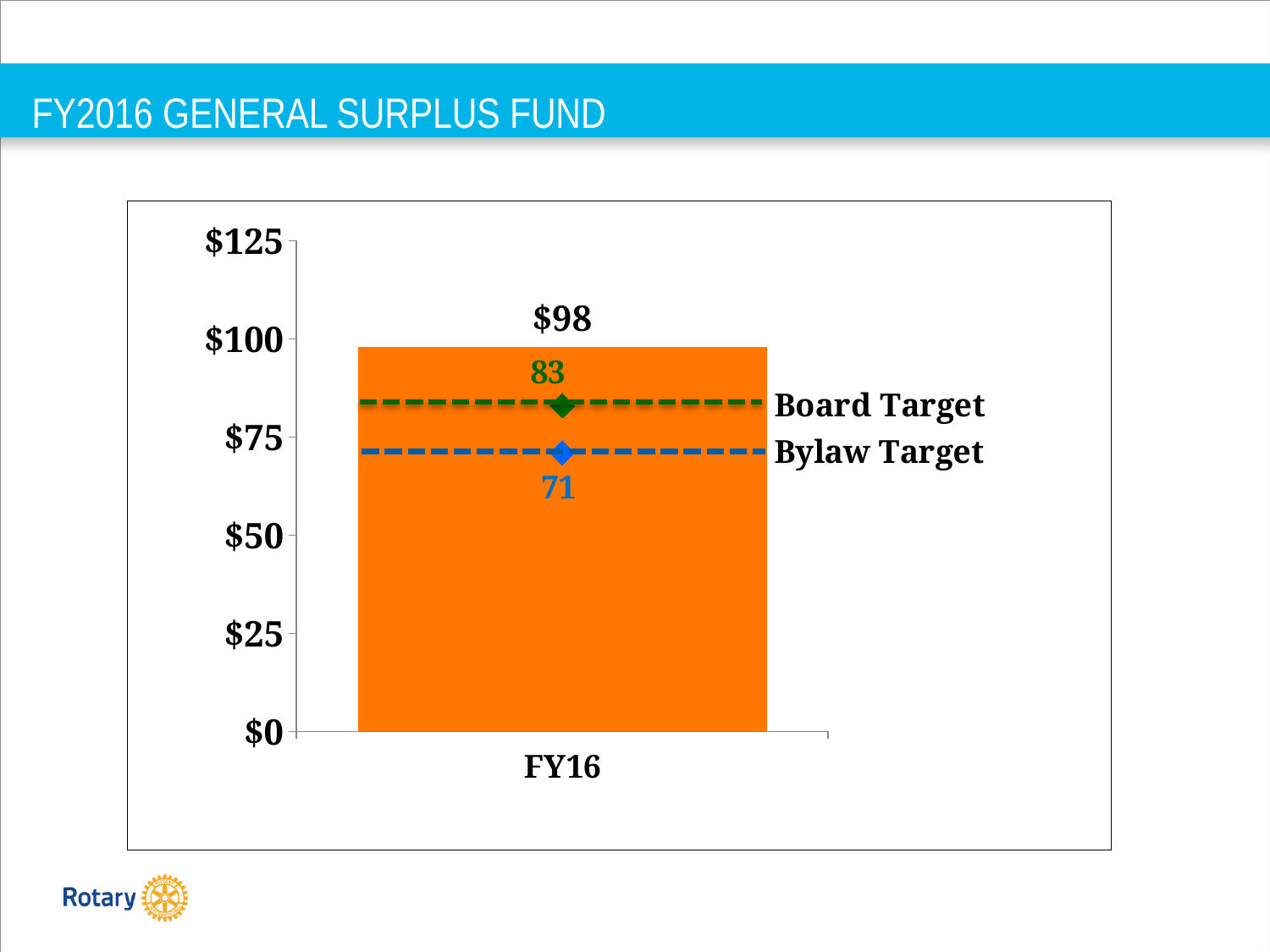
Which is higher, the Board Target or the Bylaw Target? Board Target What kind of chart is shown on the slide? bar chart What is the title of the slide? FY2016 GENERAL SURPLUS FUND What is the difference between the Board Target and the Bylaw Target? 12 What is the difference between the FY16 bar value and the Board Target? 15 Is the Bylaw Target greater or less than $75? less How many categories are shown on the x axis? 1 What is the value of the FY16 bar? $98 What is the value of the Board Target line? 83 Is the FY16 bar value greater or less than $100? less What colour is the FY16 bar? orange What is the value of the Bylaw Target line? 71